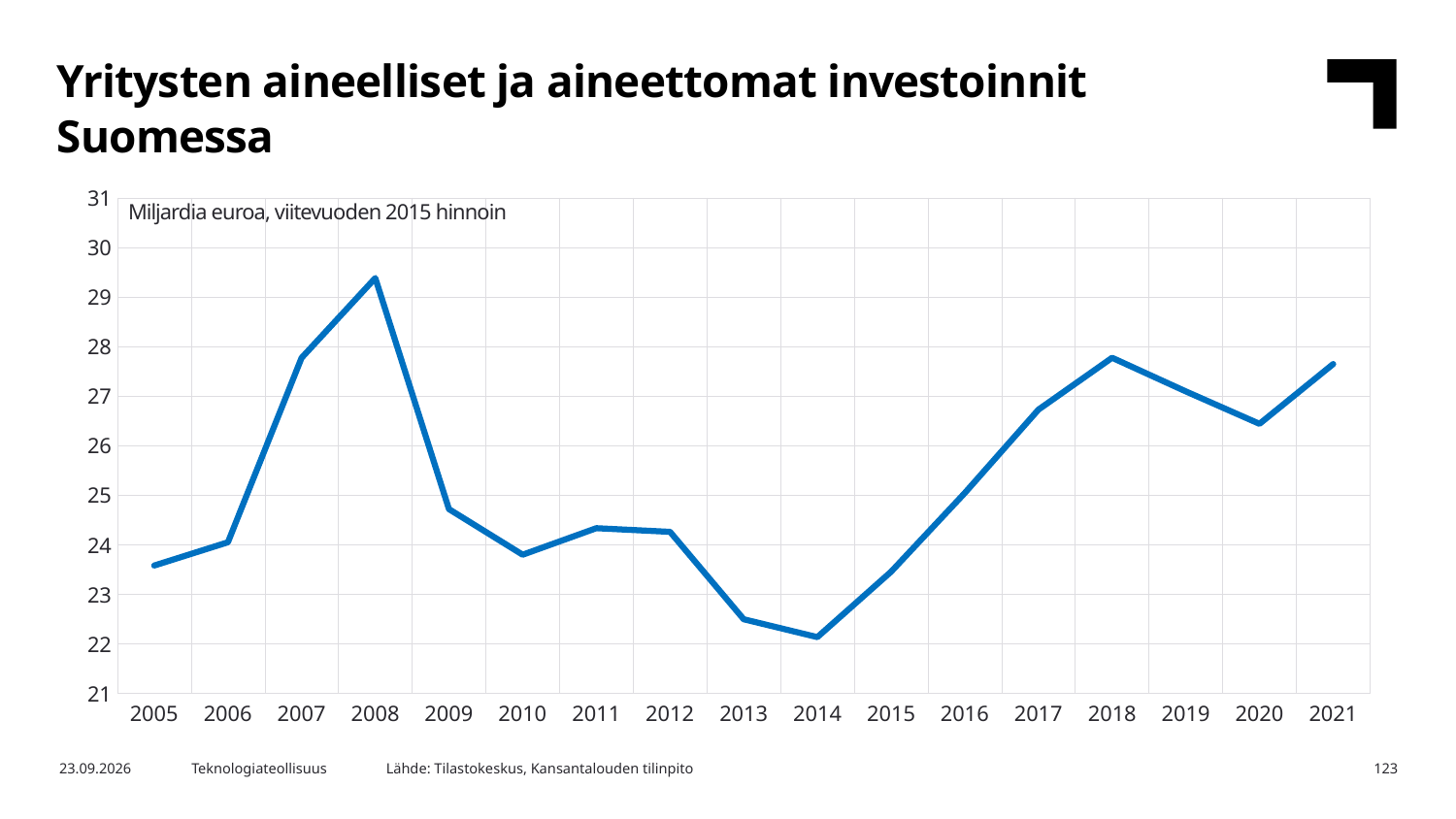
Which year has the lowest value on the chart? 2014 Which year has the larger value, 2007 or 2009? 2007 How many years are plotted on the x axis? 17 Do the values rise or fall from 2014 to 2018? rise Is the value for 2018 greater or less than 27? greater Is the value for 2014 greater or less than 23? less Is the value for 2008 greater or less than 29? greater What kind of chart is shown on the slide? line chart Which year has the larger value, 2020 or 2021? 2021 What unit is stated in the label inside the chart area? Miljardia euroa, viitevuoden 2015 hinnoin Which year has the highest value on the chart? 2008